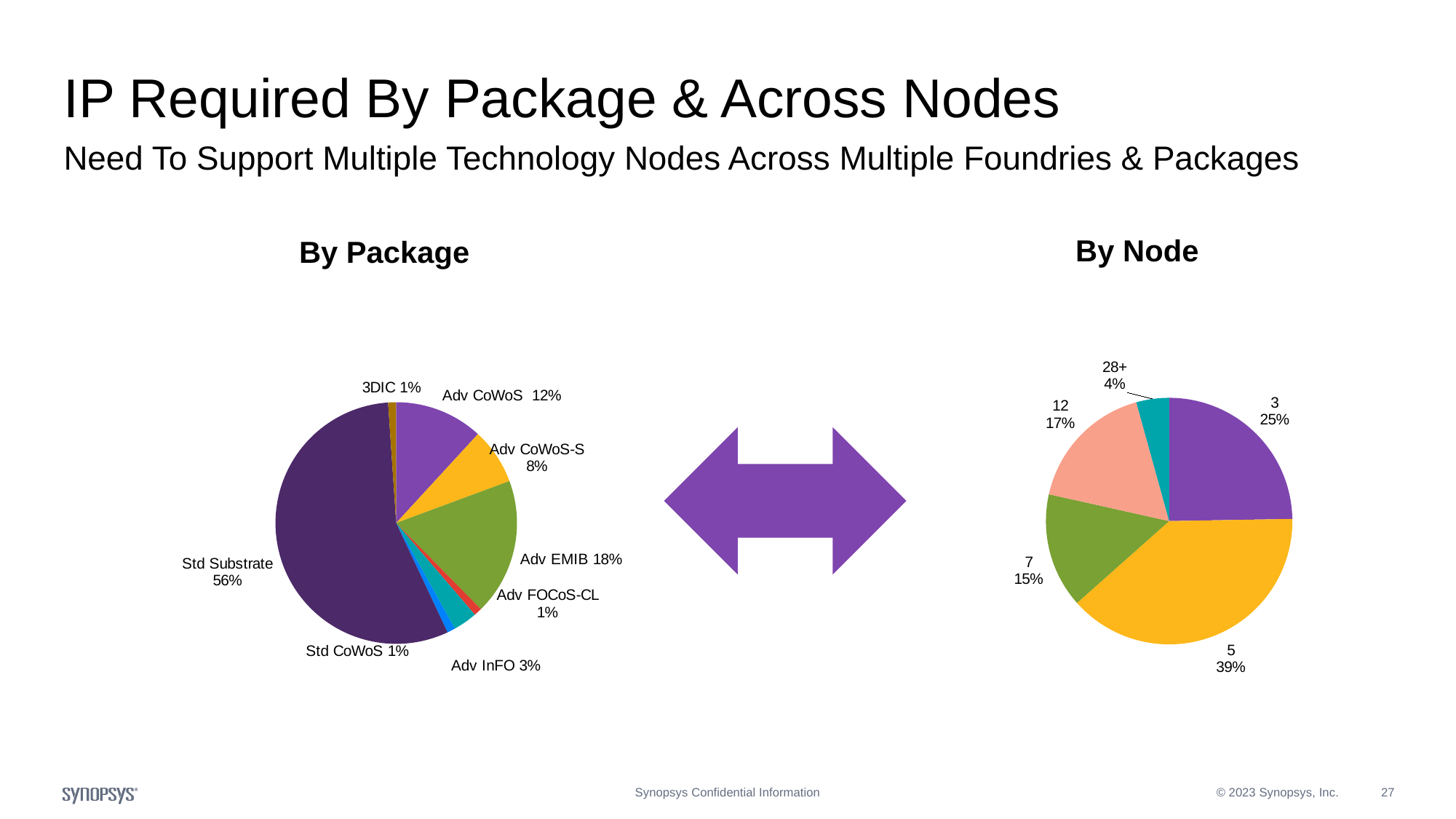
In the 'By Package' chart, what share does Adv EMIB have? 18% In the 'By Package' chart, what share does Std Substrate have? 56% In the 'By Node' chart, which node has the largest share? 5 In the 'By Node' chart, how many nodes are shown? 5 In the 'By Package' chart, which package has the largest share? Std Substrate In the 'By Node' chart, what share does node 5 have? 39% In the 'By Node' chart, what is the difference between the share of node 3 and the share of node 7? 10% What type of chart is the 'By Node' chart? Pie chart In the 'By Package' chart, how many slices are there? 8 In the 'By Node' chart, which node has the smallest share? 28+ In the 'By Package' chart, what is the difference between the Adv CoWoS share and the Adv CoWoS-S share? 4% In the 'By Package' chart, which is larger, Adv EMIB or Adv CoWoS? Adv EMIB